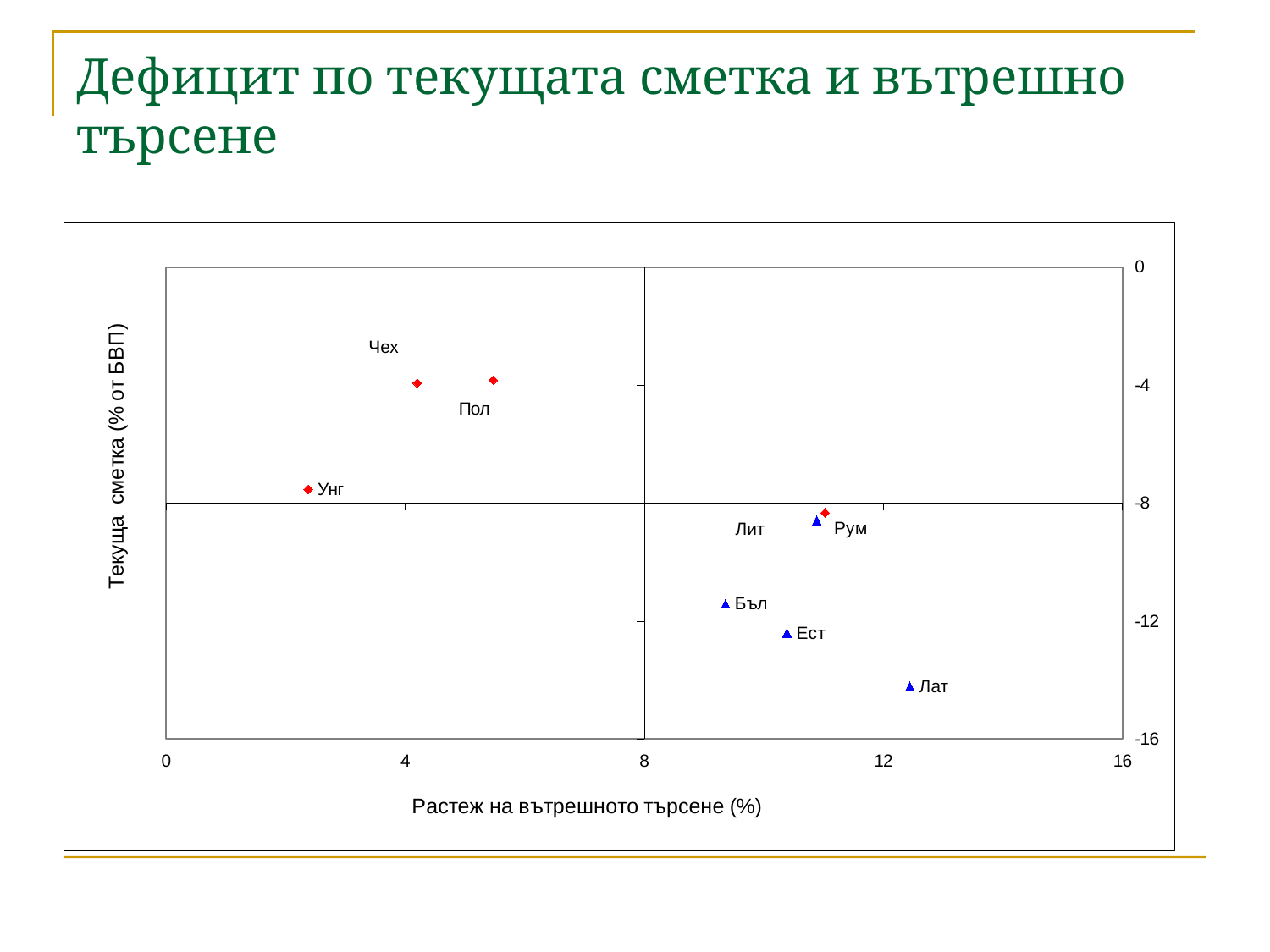
Is the current account value for Унг greater or less than -8? greater Which country has the lowest current account balance (% of GDP) on the chart? Лат Is the current account value for Ест greater or less than -12? less Is the domestic demand growth for Чех greater or less than 8? less How many countries are plotted on the chart? 8 What kind of chart is shown on the slide? scatter chart Which has a higher current account balance, Пол or Бъл? Пол Which country has the lowest domestic demand growth on the chart? Унг Which country has the highest domestic demand growth on the chart? Лат What is the label of the horizontal axis of the chart? Растеж на вътрешното търсене (%) Which has a higher domestic demand growth, Бъл or Лат? Лат